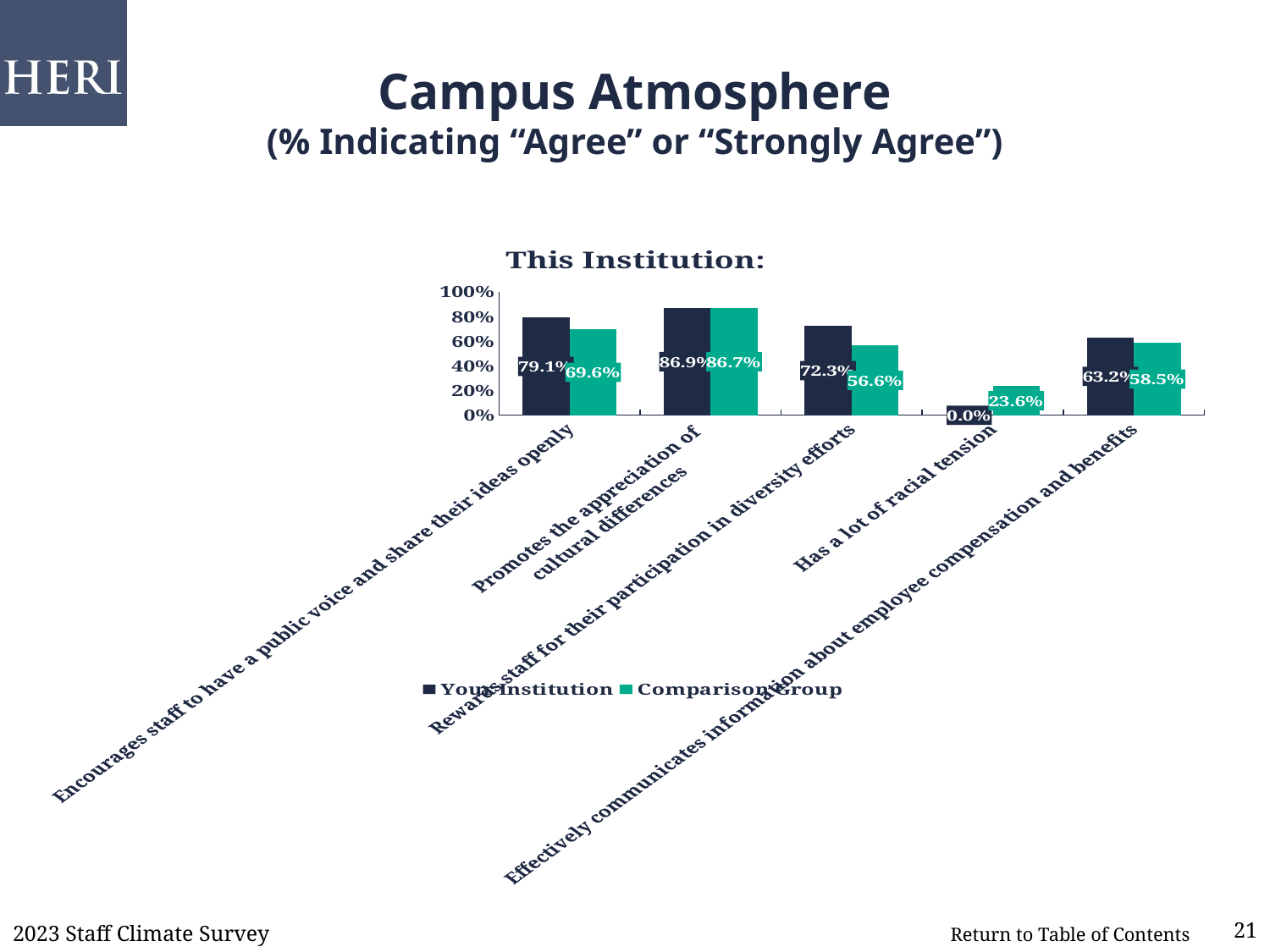
What is the Your Institution value for "Effectively communicates information about employee compensation and benefits"? 63.2% What is the title printed above the chart? This Institution: What is the Comparison Group value for "Rewards staff for their participation in diversity efforts"? 56.6% What is the Comparison Group value for "Has a lot of racial tension"? 23.6% What is the Your Institution value for "Encourages staff to have a public voice and share their ideas openly"? 79.1% How many categories are shown on the x axis? 5 For "Encourages staff to have a public voice and share their ideas openly", which is larger: Your Institution or Comparison Group? Your Institution Which category has the lowest Comparison Group value? Has a lot of racial tension Which category has the highest Your Institution value? Promotes the appreciation of cultural differences What is the difference between the Your Institution and Comparison Group values for "Rewards staff for their participation in diversity efforts"? 15.7% What kind of chart is shown on the slide? Bar chart How many series does the legend list? 2